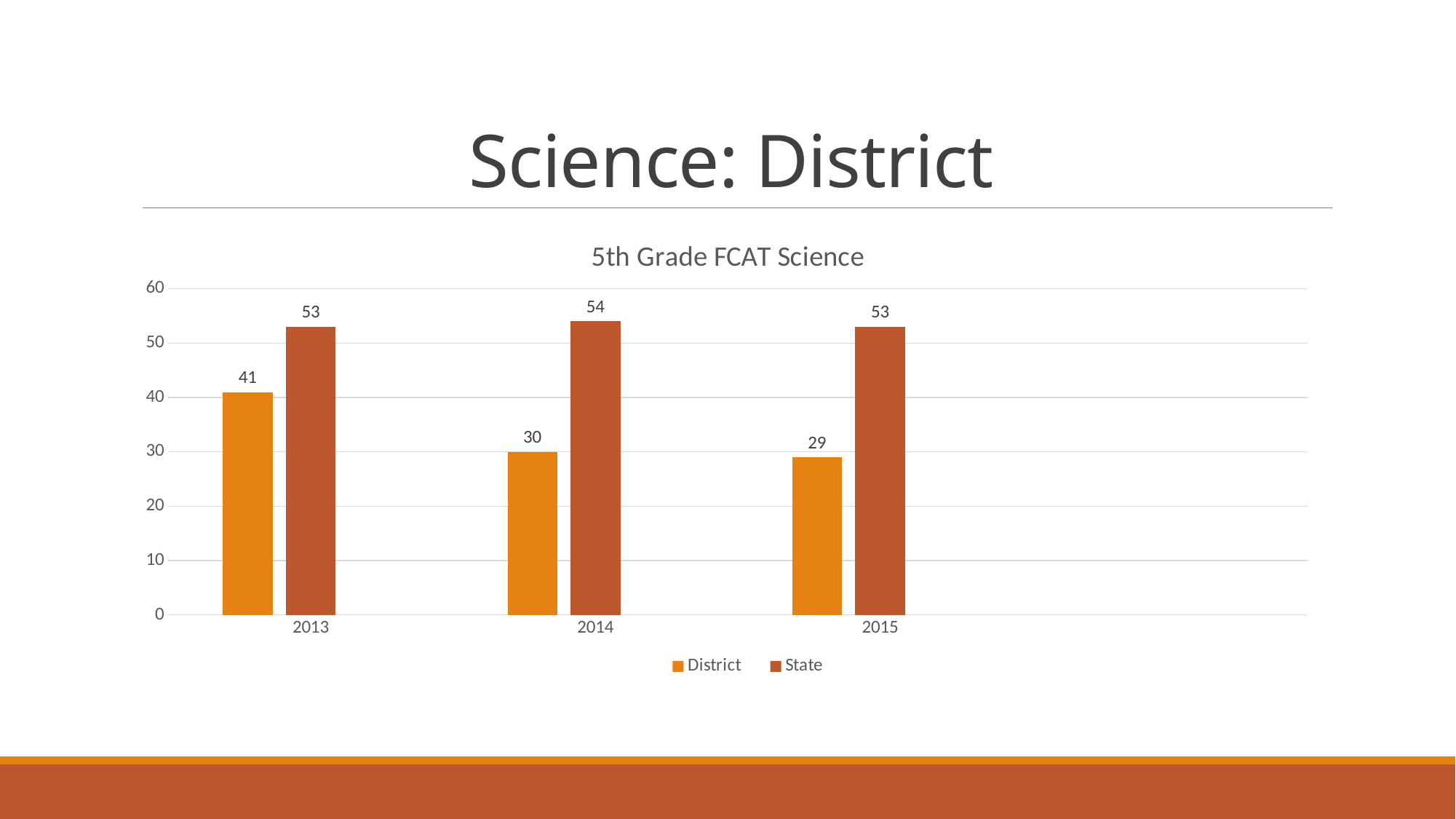
Which is larger in 2013, the District value or the State value? State Does the District value rise or fall from 2013 to 2015? fall Which year has the lowest District value? 2015 What is the State value for 2014? 54 What kind of chart is shown? bar chart How many series does the legend list? 2 Is the District value for 2014 greater or less than 40? less What is the District value for 2015? 29 Which year has the highest State value? 2014 What is the District value for 2013? 41 How many years are shown on the x axis? 3 What is the difference between the State and District values in 2014? 24